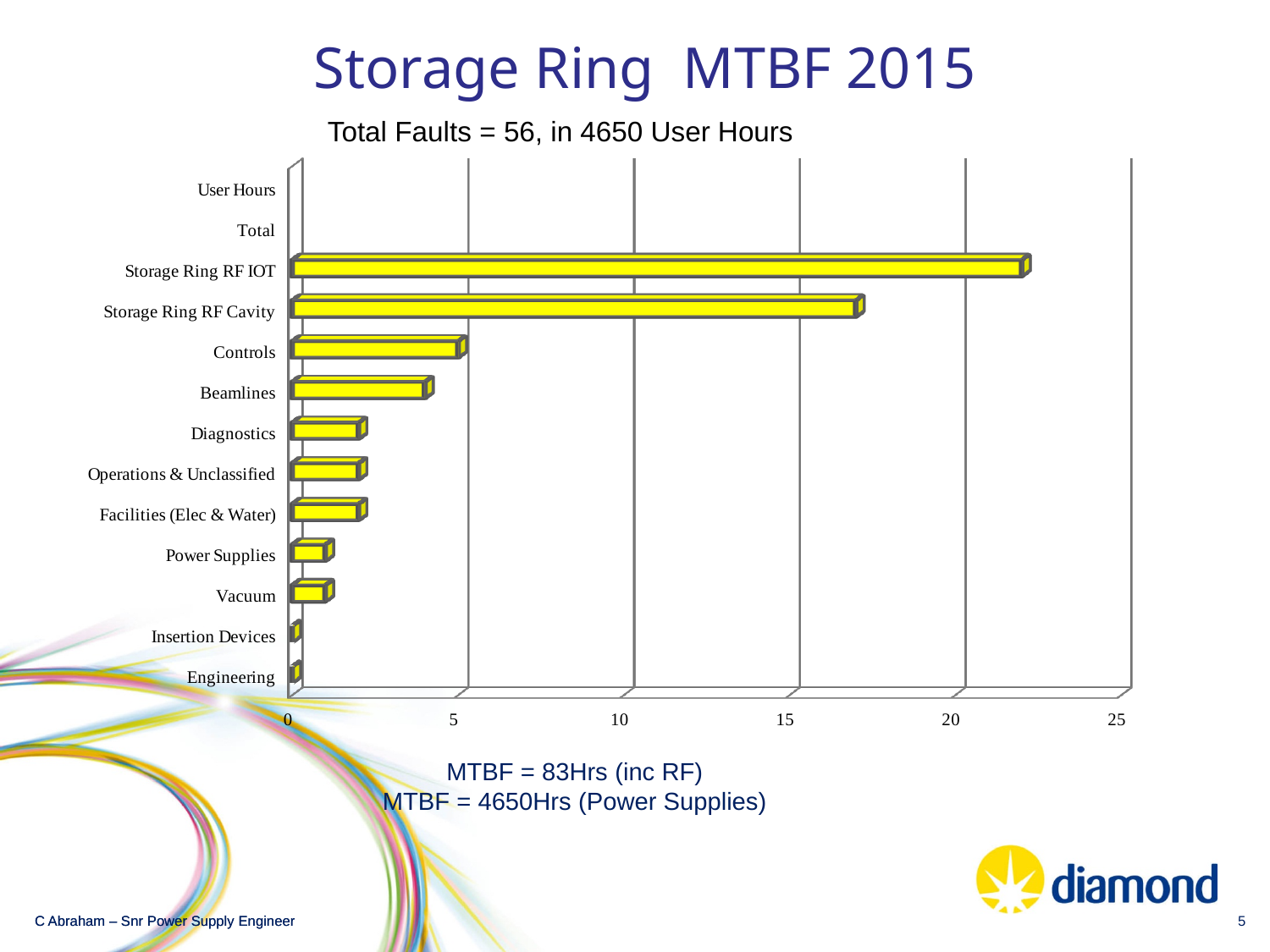
Is the value for Power Supplies greater or less than 5? less Is the value for Storage Ring RF Cavity greater or less than 15? greater Which category has the longest bar in the chart? Storage Ring RF IOT Is the value for Storage Ring RF Cavity greater or less than 20? less What kind of chart is shown on the slide? bar chart How many categories are listed on the vertical axis of the chart? 13 Which is larger, the value for Storage Ring RF Cavity or the value for Controls? Storage Ring RF Cavity Which is larger, the value for Beamlines or the value for Diagnostics? Beamlines What is the highest value shown on the horizontal axis of the chart? 25 What is the title of the chart on the slide? Storage Ring MTBF 2015